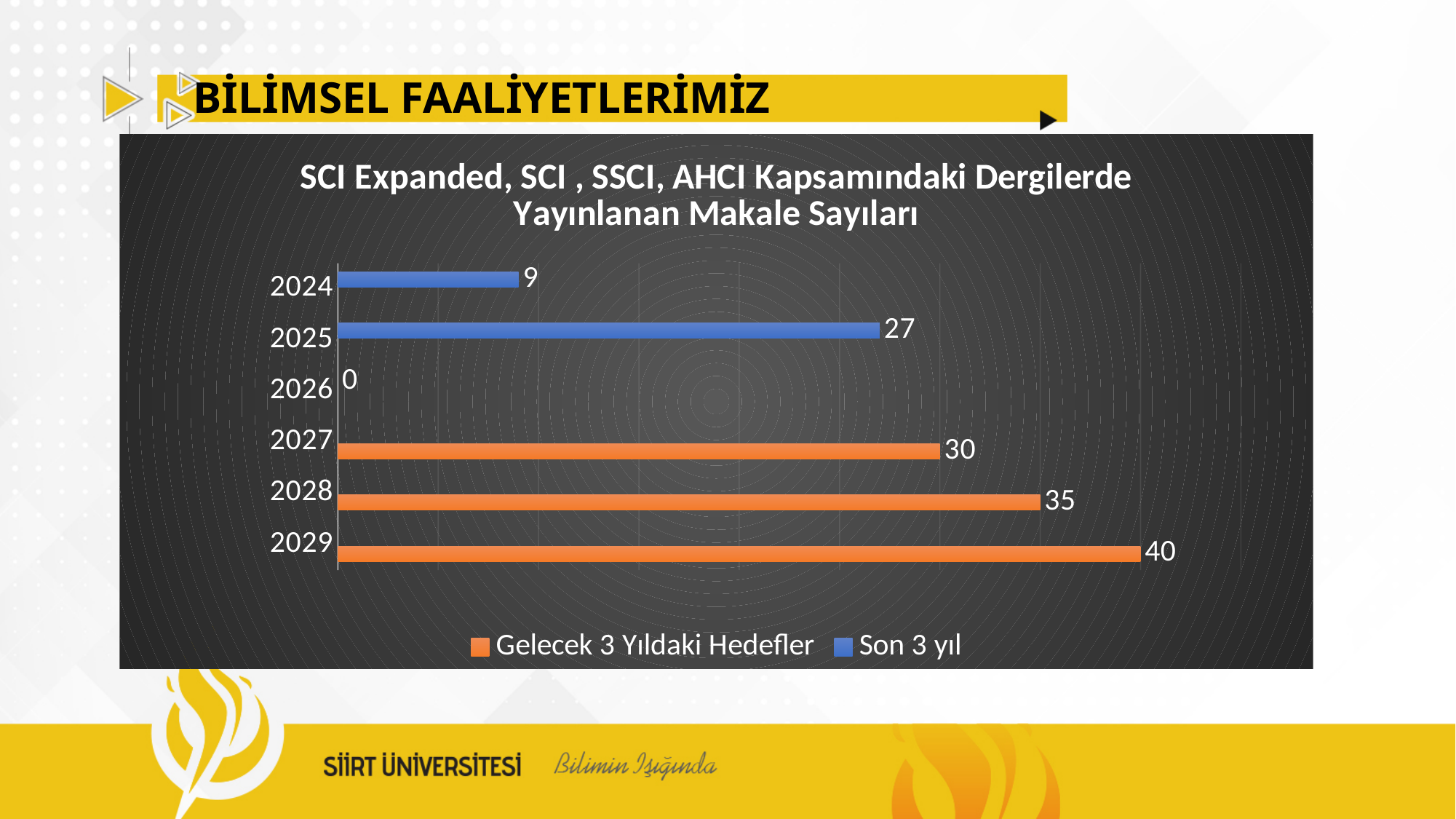
What is the difference between the 2025 value and the 2024 value? 18 What is the difference between the 2028 target and the 2027 target? 5 What is the target value for 2029 in the 'Gelecek 3 Yıldaki Hedefler' series? 40 What is the value for 2025 in the 'Son 3 yıl' series? 27 Which is larger, the value for 2025 or the target for 2027? 2027 What is the target value for 2027? 30 Which year has the lowest value on the chart? 2026 Which year has the highest value on the chart? 2029 What is the value shown for 2026? 0 What is the value for 2024 in the 'Son 3 yıl' series? 9 What type of chart is shown on the slide? Bar chart How many series does the legend list? 2